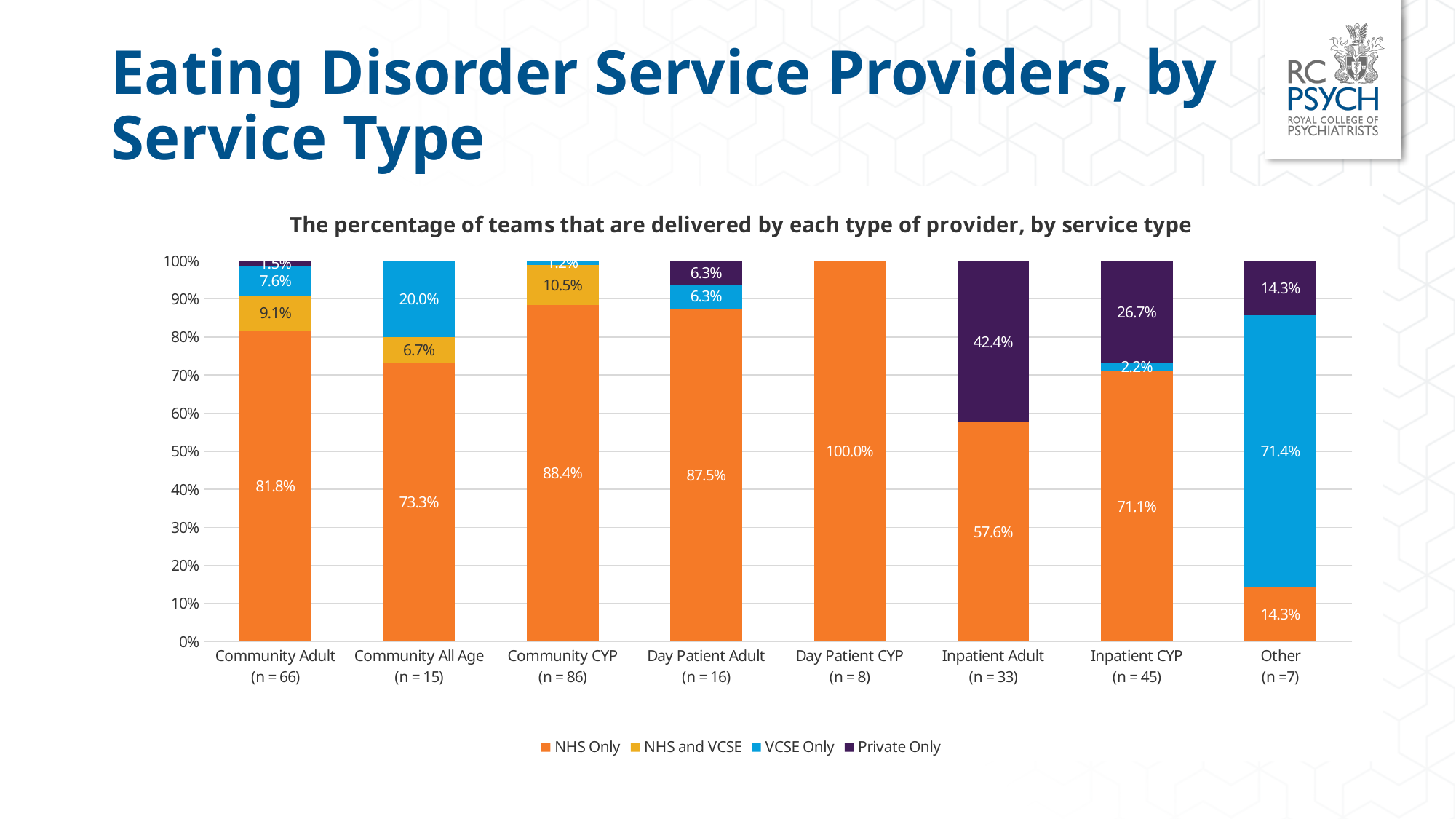
What is the sample size (n) shown for Community CYP? 86 What is the NHS and VCSE value for Community CYP? 10.5% What is the Private Only share for Inpatient CYP? 26.7% Which service type has the lowest NHS Only percentage? Other What is the difference between the NHS Only percentages for Community CYP and Community All Age? 15.1% What kind of chart is shown on the slide? Stacked bar chart Which service type has the highest NHS Only percentage? Day Patient CYP Which is larger: the Private Only share for Inpatient Adult or for Inpatient CYP? Inpatient Adult How many series does the legend list? 4 What is the VCSE Only value for the Other service type? 71.4% How many service types are shown on the x axis? 8 What percentage of Inpatient Adult teams are delivered by NHS Only providers? 57.6%